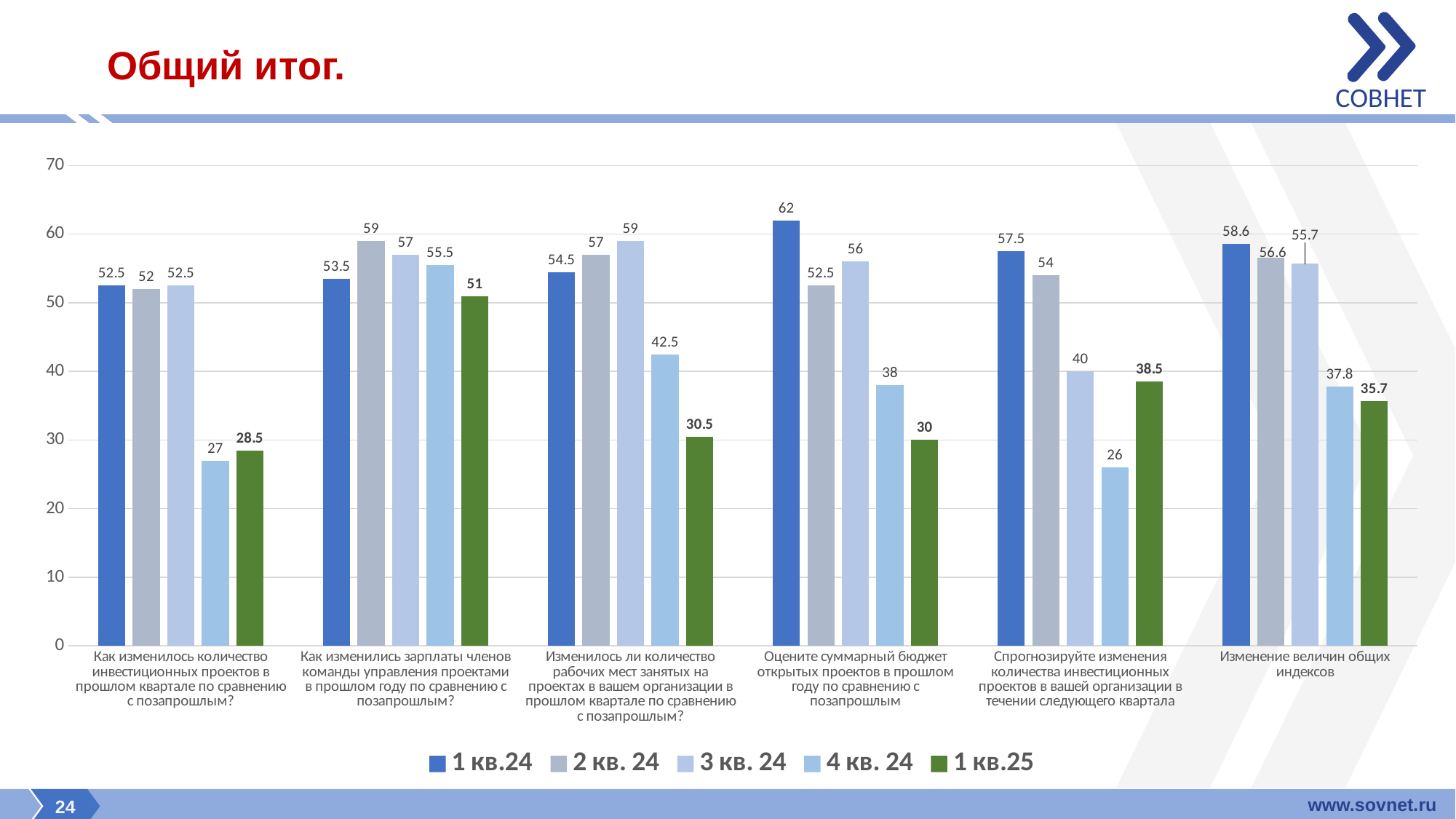
What is the value for 1 кв.24 in the category "Оцените суммарный бюджет открытых проектов в прошлом году по сравнению с позапрошлым"? 62 In the category "Изменилось ли количество рабочих мест занятых на проектах в вашем организации в прошлом квартале по сравнению с позапрошлым?", which is larger: the value for 3 кв. 24 or the value for 4 кв. 24? 3 кв. 24 Which series has the highest value in the category "Как изменились зарплаты членов команды управления проектами в прошлом году по сравнению с позапрошлым?"? 2 кв. 24 What kind of chart is shown on the slide? Bar chart What colour are the bars for the 1 кв.25 series? Green What is the difference between the 1 кв.24 and 1 кв.25 values in the category "Оцените суммарный бюджет открытых проектов в прошлом году по сравнению с позапрошлым"? 32 Is the value for 1 кв.25 in the category "Изменение величин общих индексов" greater or less than 40? less What is the value for 1 кв.25 in the category "Изменение величин общих индексов"? 35.7 How many series does the legend list? 5 Which series has the lowest value in the category "Как изменилось количество инвестиционных проектов в прошлом квартале по сравнению с позапрошлым?"? 4 кв. 24 What is the value for 4 кв. 24 in the category "Спрогнозируйте изменения количества инвестиционных проектов в вашей организации в течении следующего квартала"? 26 How many categories are shown on the x axis? 6